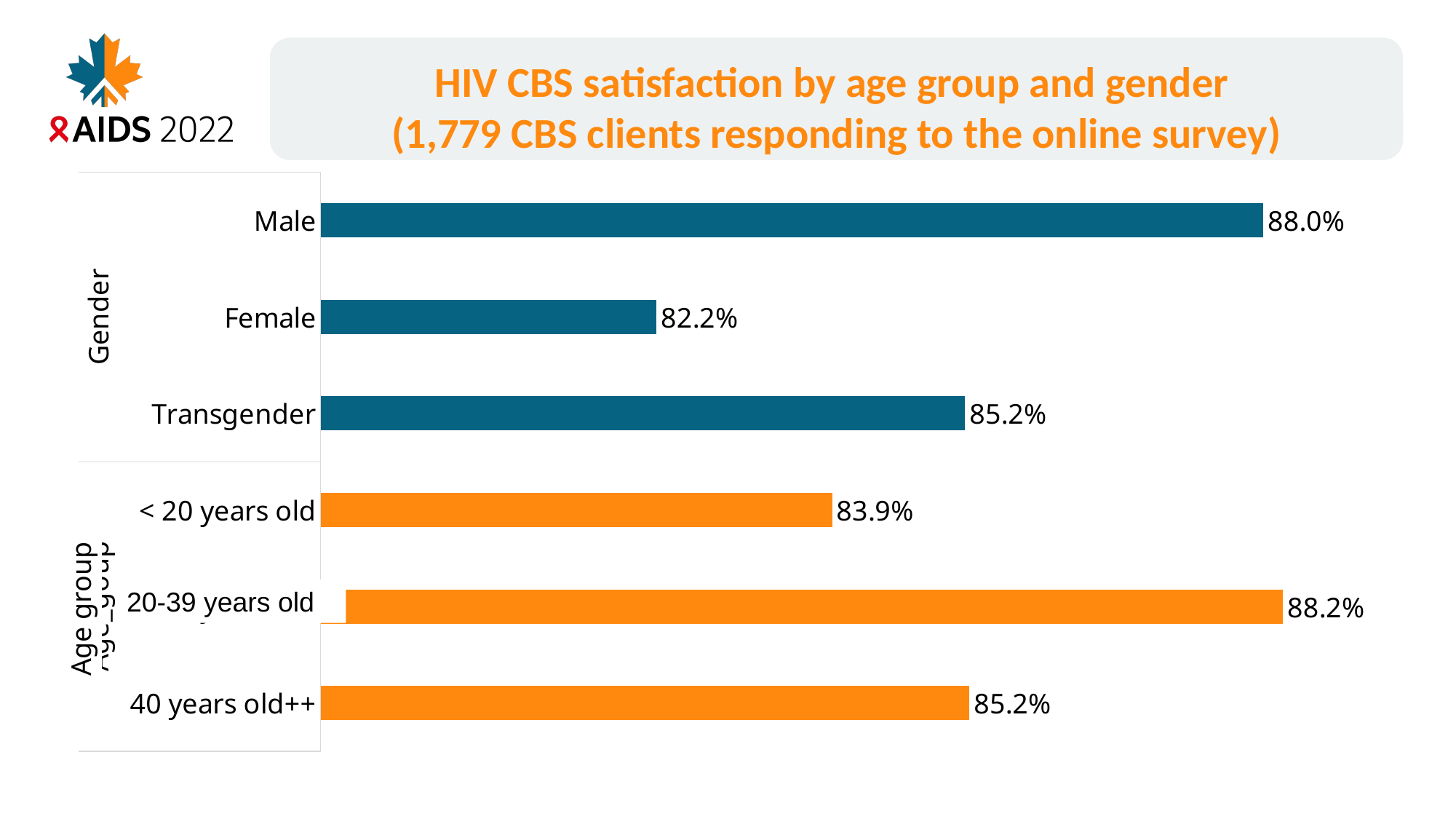
What colour are the bars for the age group categories? Orange What kind of chart is shown on the slide? Bar chart What is the difference between the Male and Female satisfaction values? 5.8% What is the satisfaction value for Male? 88.0% Which has a higher satisfaction value, Transgender or Female? Transgender Which category has the lowest satisfaction value on the chart? Female What is the satisfaction value for Female? 82.2% What is the satisfaction value for the 20-39 years old age group? 88.2% What is the difference between the 20-39 years old and < 20 years old satisfaction values? 4.3% Which category has the highest satisfaction value on the chart? 20-39 years old What is the satisfaction value for the < 20 years old age group? 83.9% How many categories are plotted on the chart? 6